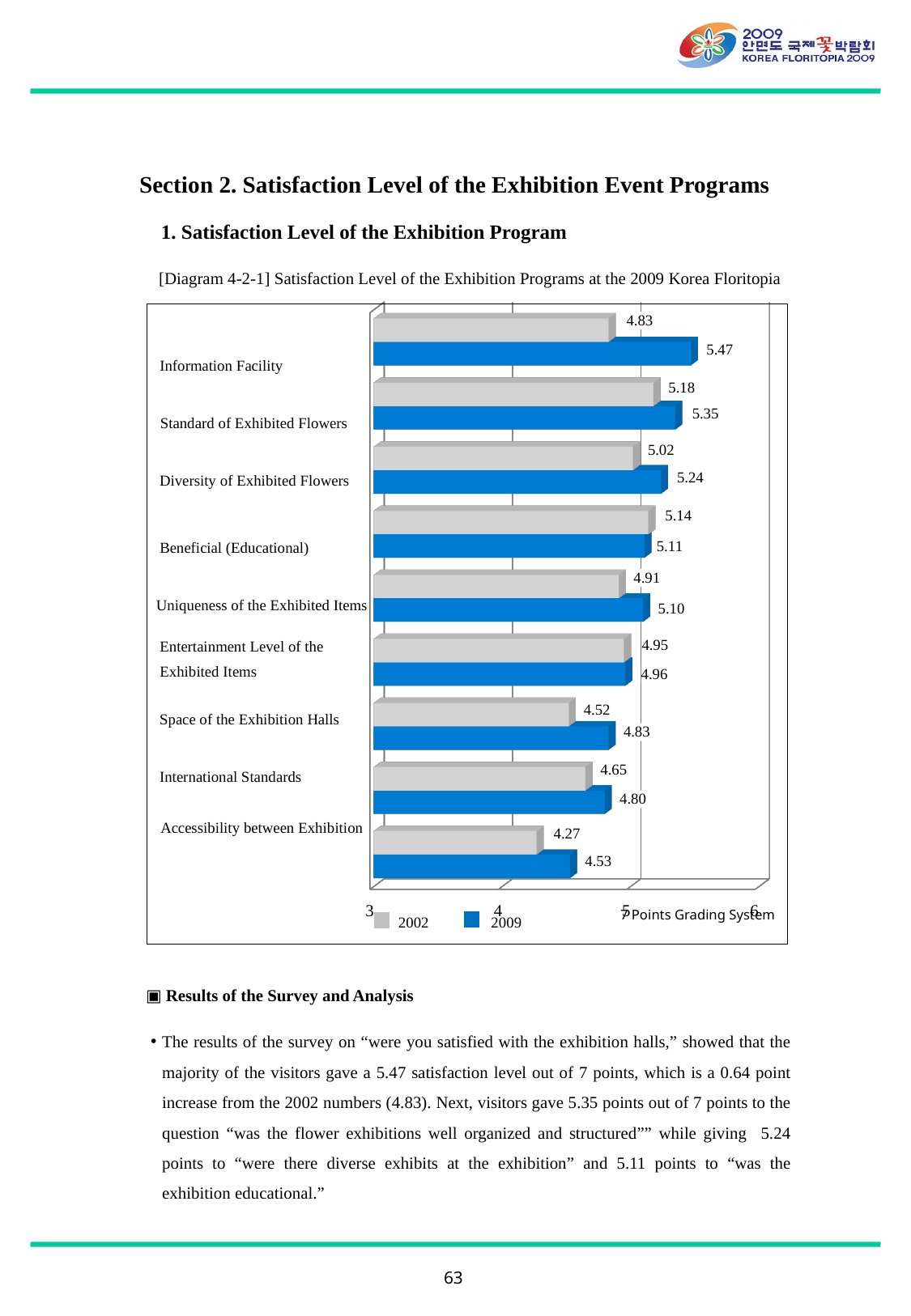
Which is larger for Diversity of Exhibited Flowers, the 2002 value or the 2009 value? 2009 What is the 2002 satisfaction value for Space of the Exhibition Halls? 4.52 How many categories are shown in the chart? 9 Which category has the lowest 2002 value? Accessibility between Exhibition Which category has the highest 2009 value? Information Facility What is the 2009 satisfaction value for Information Facility? 5.47 What is the 2009 value for Uniqueness of the Exhibited Items? 5.10 What is the difference between the 2009 and 2002 values for Information Facility? 0.64 How many series does the legend list? 2 Is the 2002 value for Accessibility between Exhibition greater or less than 5? less What kind of chart is shown? bar chart Which category has the highest 2002 value? Standard of Exhibited Flowers